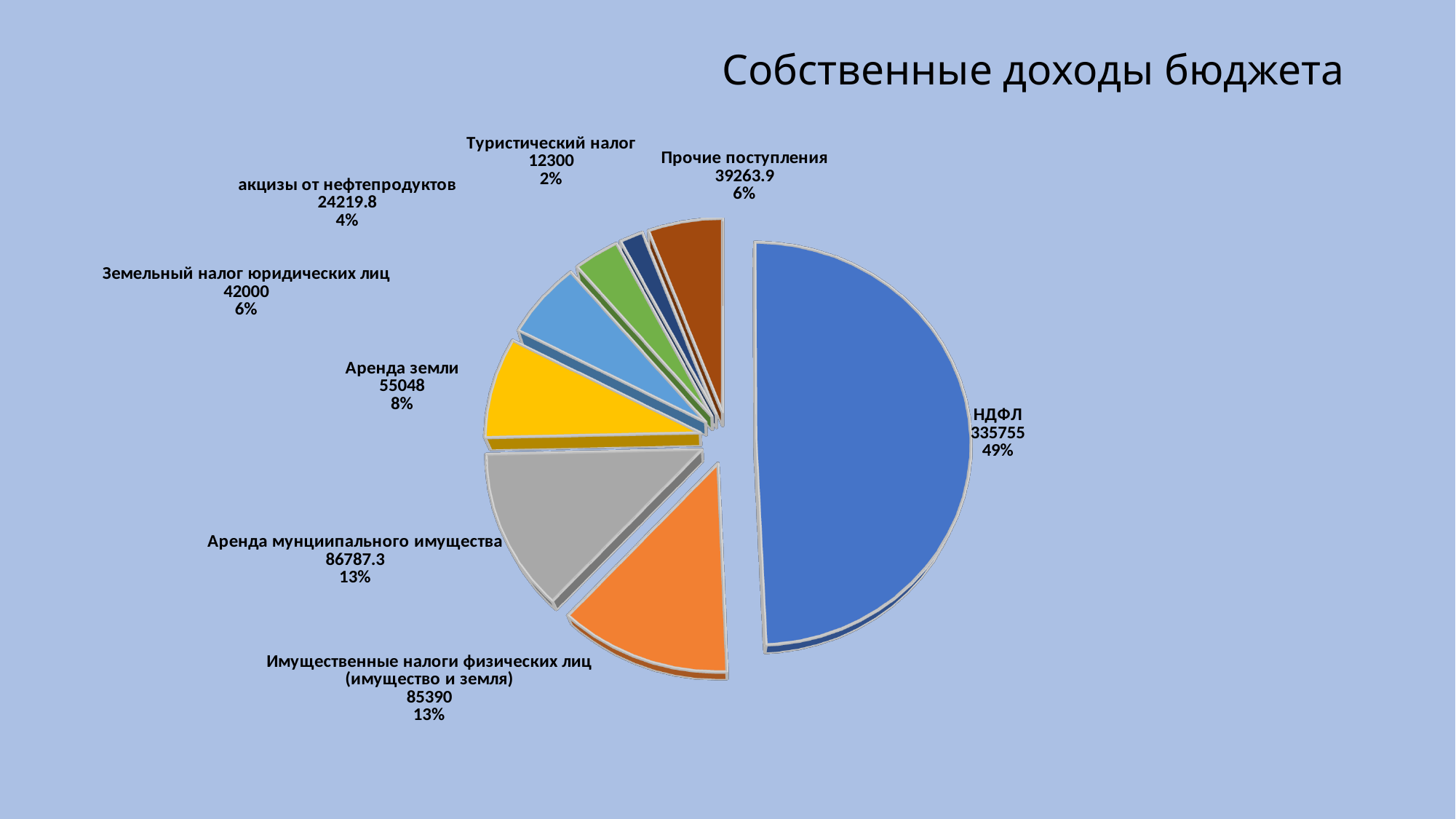
What is the title of the chart? Собственные доходы бюджета What is the value for НДФЛ? 335755 What is the value for Прочие поступления? 39263.9 Which is larger: Земельный налог юридических лиц or акцизы от нефтепродуктов? Земельный налог юридических лиц What share of the pie does Туристический налог represent? 2% Which category has the largest slice? НДФЛ What is the difference between Аренда мунциипального имущества and Имущественные налоги физических лиц (имущество и земля)? 1397.3 What share of the pie does НДФЛ represent? 49% What is the value for Аренда земли? 55048 How many slices does the pie chart have? 8 What kind of chart is shown on the slide? pie chart Which category has the smallest slice? Туристический налог